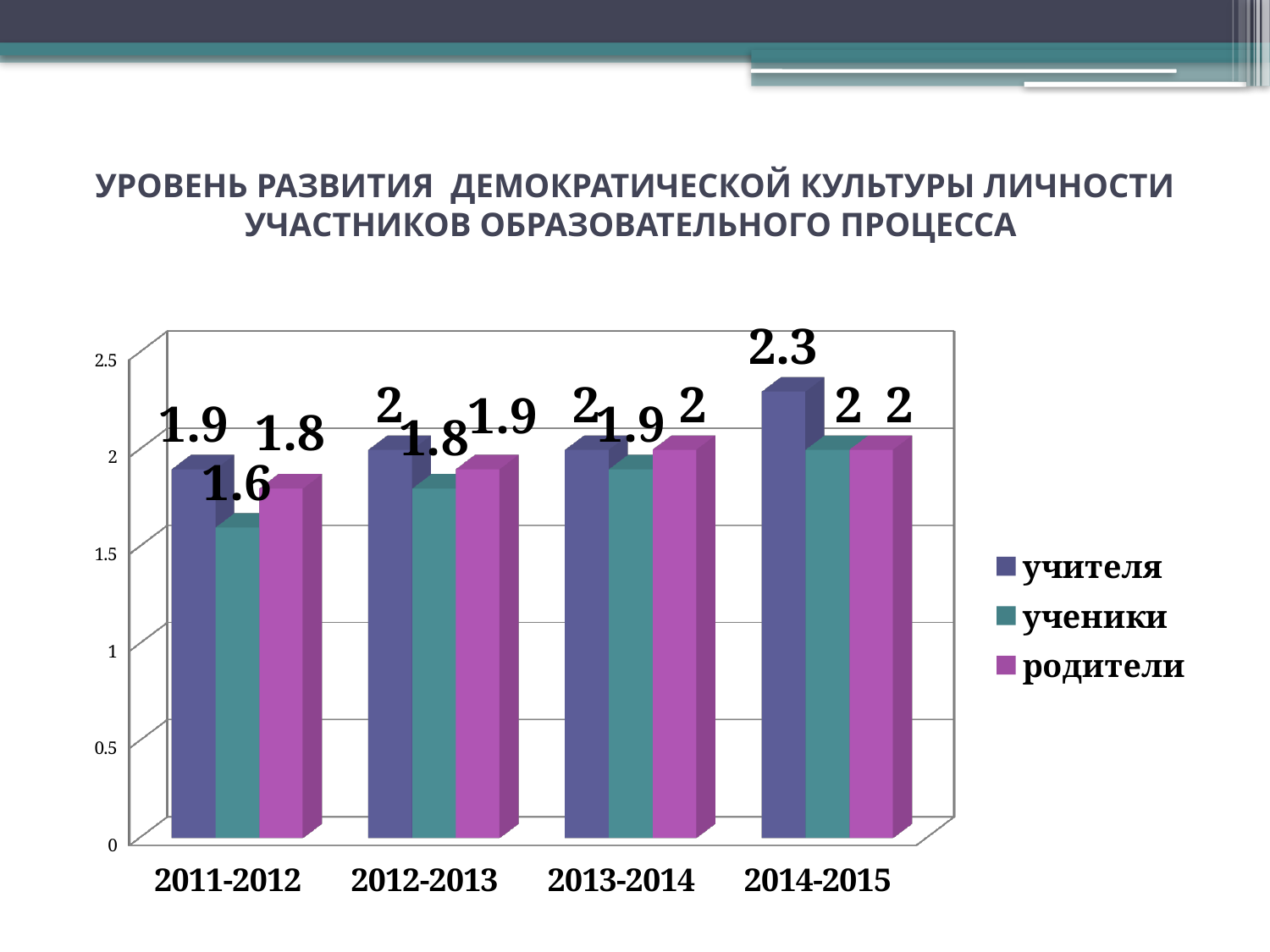
What is the value for ученики in 2013-2014? 1.9 What is the value for учителя in 2014-2015? 2.3 What kind of chart is shown on the slide? bar chart What is the difference between the учителя value and the ученики value in 2011-2012? 0.3 What is the value for ученики in 2011-2012? 1.6 Do the values for ученики rise or fall from 2011-2012 to 2014-2015? rise In which period is the value for учителя highest? 2014-2015 How many periods are shown on the x axis? 4 What is the value for родители in 2012-2013? 1.9 In which period is the value for ученики lowest? 2011-2012 How many series does the legend list? 3 Which is larger in 2012-2013: the value for ученики or the value for родители? родители